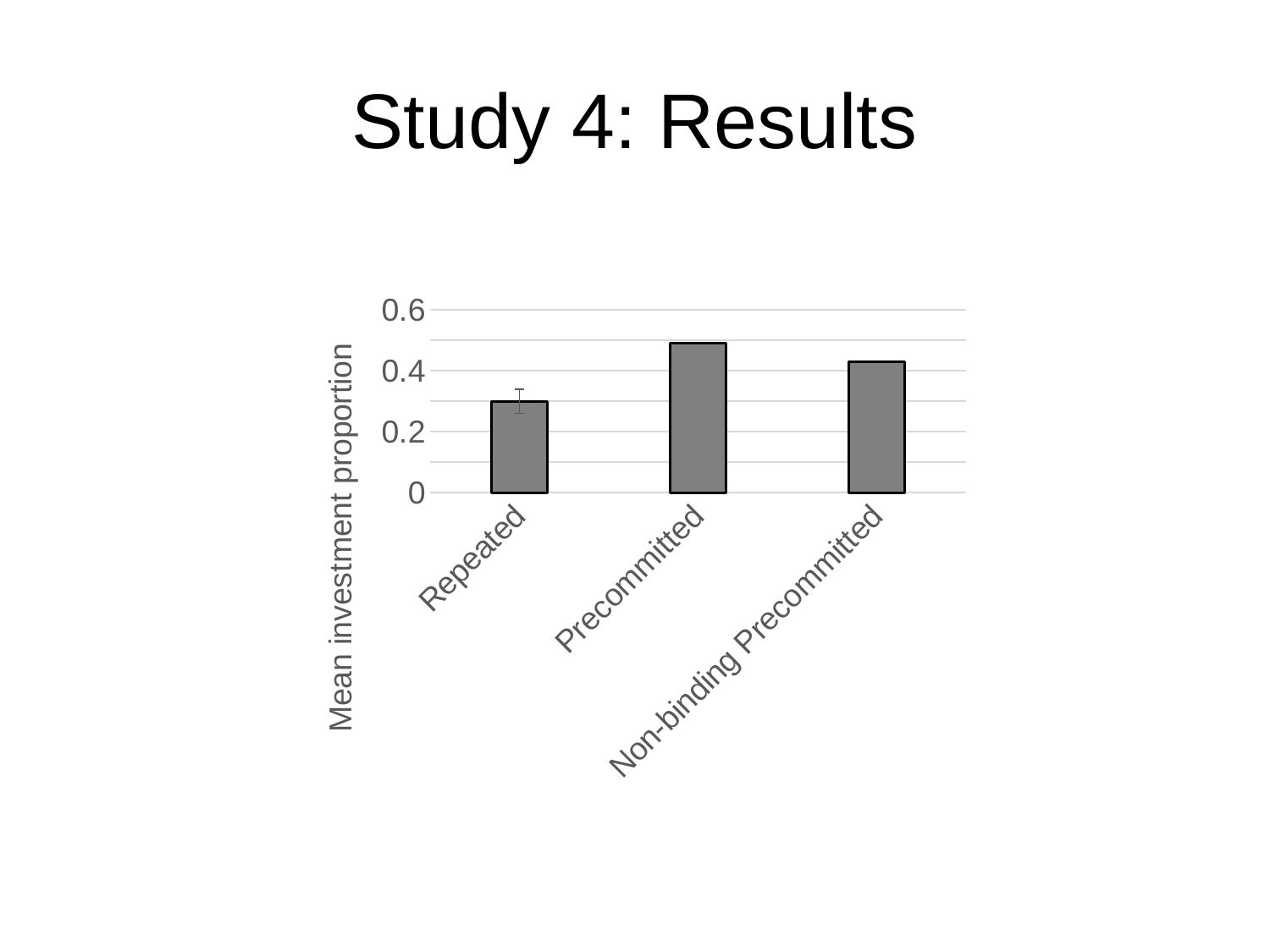
Is the value for Non-binding Precommitted greater or less than 0.6? less Which is larger, the value for Repeated or the value for Non-binding Precommitted? Non-binding Precommitted Which category has the highest mean investment proportion? Precommitted Is the value for Non-binding Precommitted greater or less than 0.4? greater Is the value for Precommitted greater or less than 0.4? greater How many categories are plotted on the x axis? 3 Which is larger, the value for Precommitted or the value for Non-binding Precommitted? Precommitted What is the label on the vertical axis of the chart? Mean investment proportion What kind of chart is shown on the slide? bar chart Which category has the lowest mean investment proportion? Repeated